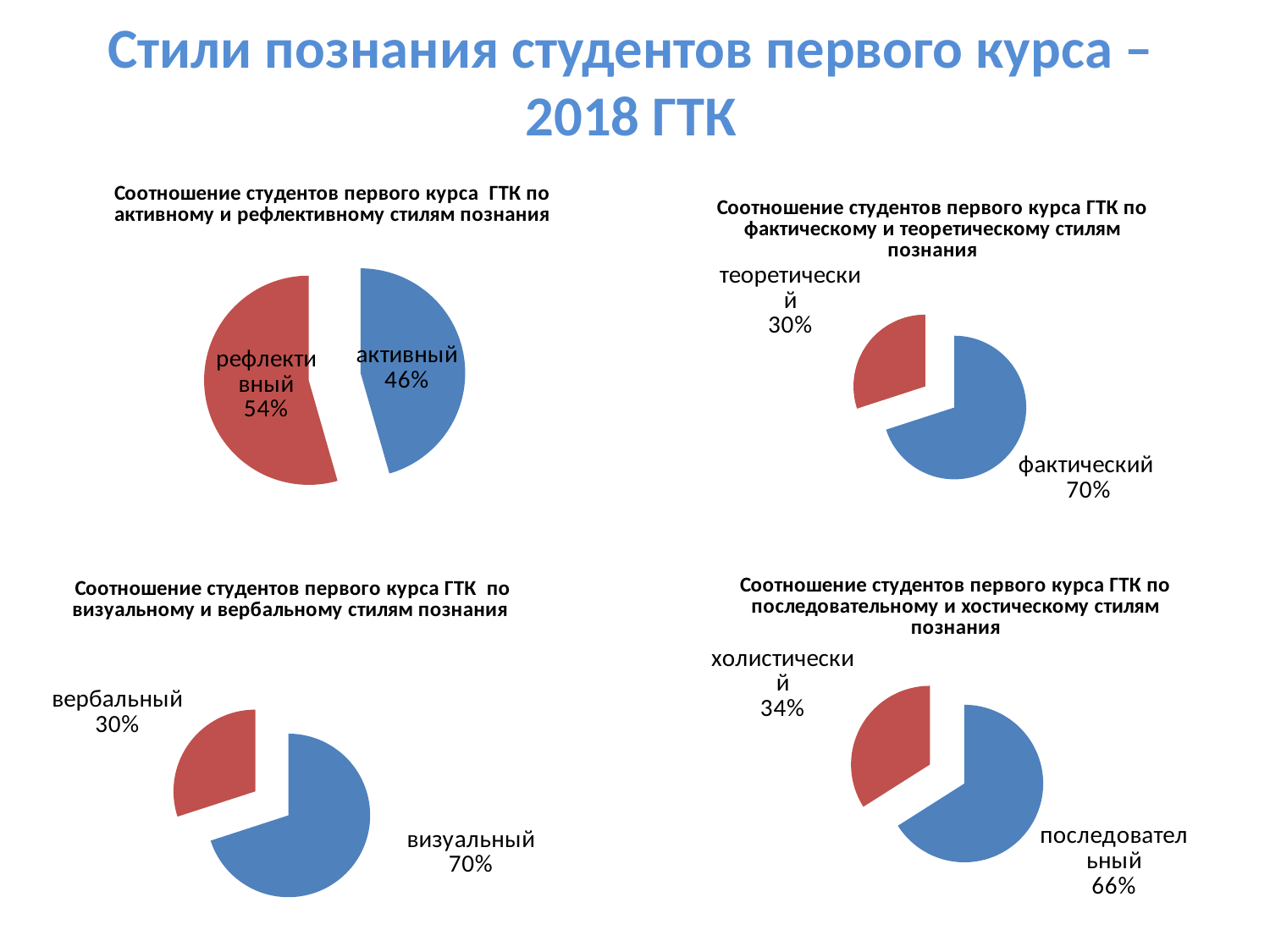
In the top-left pie chart (active vs reflective styles), what is the difference between the рефлективный and активный shares? 8% In the bottom-right pie chart (sequential vs holistic styles), what share is labelled for холистический? 34% In the top-right pie chart (factual vs theoretical styles), what share is labelled for теоретический? 30% What type of chart is the top-right chart (factual vs theoretical styles)? pie chart How many charts are shown on the slide? 4 In the top-left pie chart (active vs reflective styles), what share is labelled for активный? 46% In the top-left pie chart (active vs reflective styles), what share is labelled for рефлективный? 54% In the bottom-left pie chart (visual vs verbal styles), what is the difference between the визуальный and вербальный shares? 40% In the bottom-right pie chart (sequential vs holistic styles), which slice is the largest? последовательный How many slices does the bottom-right pie chart (sequential vs holistic styles) have? 2 In the top-right pie chart (factual vs theoretical styles), which slice is larger, фактический or теоретический? фактический In the bottom-left pie chart (visual vs verbal styles), what share is labelled for визуальный? 70%